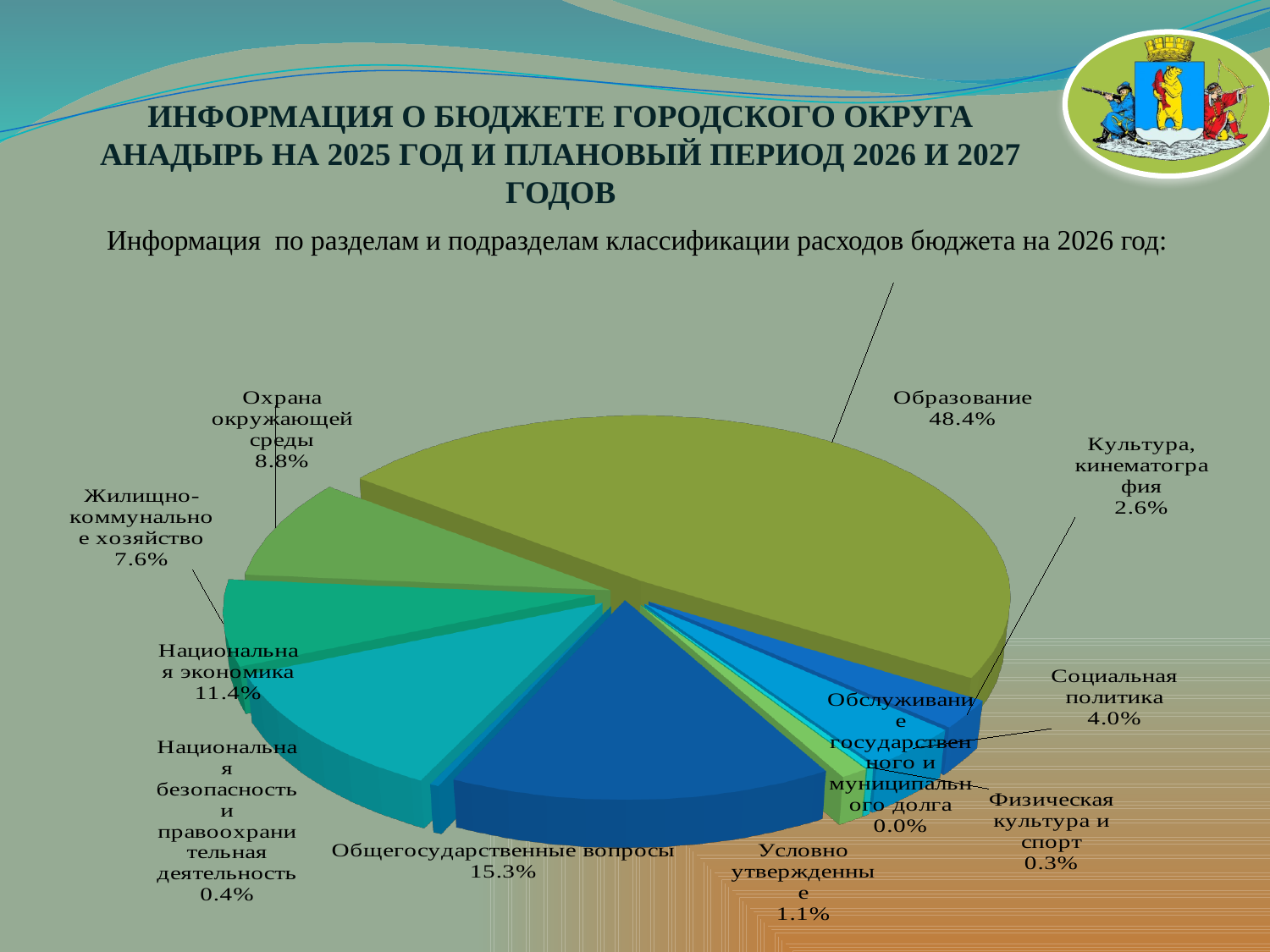
What kind of chart is shown on the slide? pie chart What share is shown for Национальная экономика? 11.4% Which has a larger share: Охрана окружающей среды or Жилищно-коммунальное хозяйство? Охрана окружающей среды What share is shown for Жилищно-коммунальное хозяйство? 7.6% What share of the 2026 budget expenditures goes to Образование? 48.4% What share is shown for Обслуживание государственного и муниципального долга? 0.0% Which category has the smallest share of the pie? Обслуживание государственного и муниципального долга How many categories are shown in the pie chart? 11 Which category has the largest share of the pie? Образование Which year's budget expenditure classification does the chart describe? 2026 What share is shown for Общегосударственные вопросы? 15.3% What is the difference between the shares of Образование and Общегосударственные вопросы? 33.1%